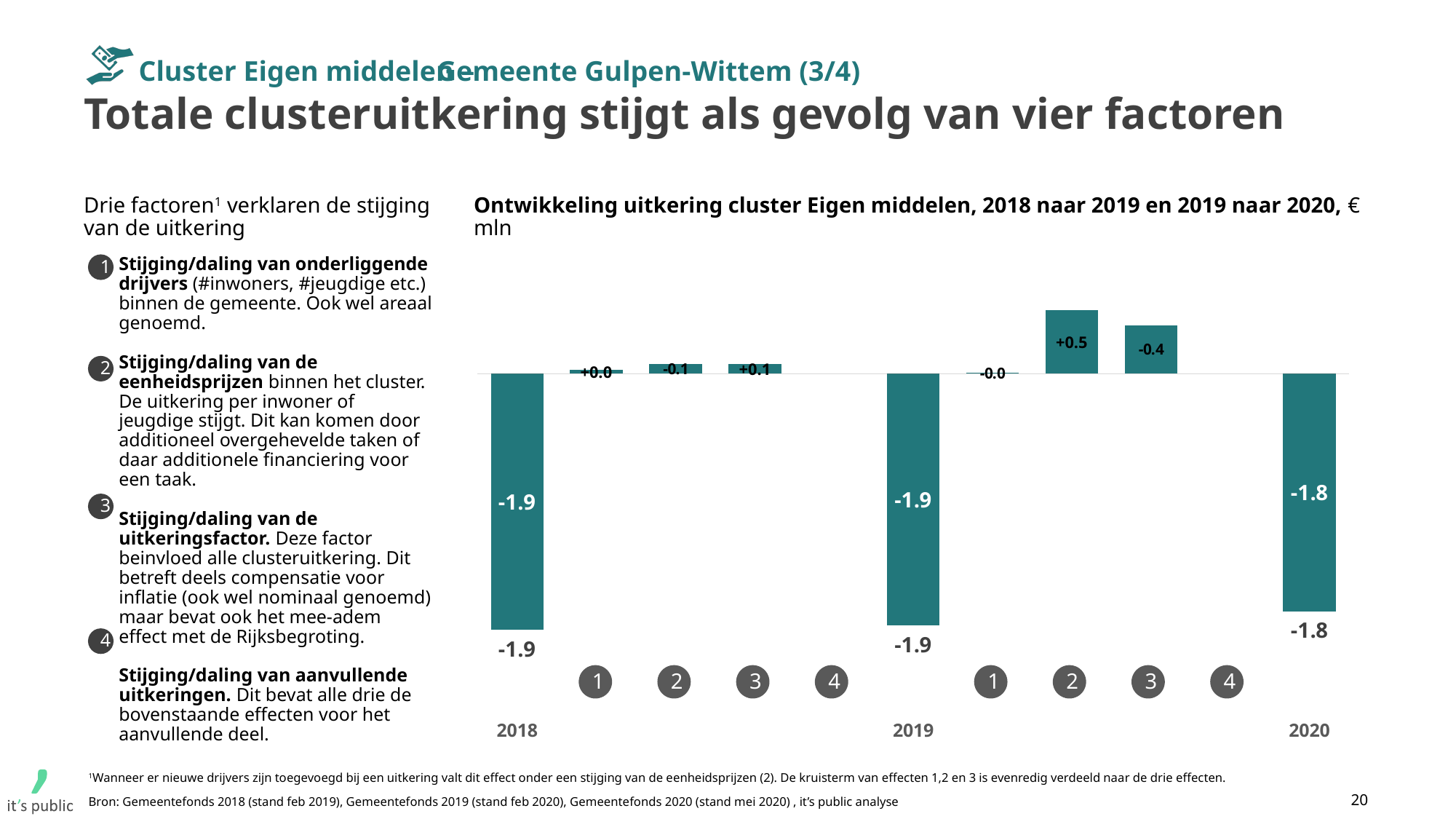
What is the value of factor 3 between 2019 and 2020 in the chart? -0.4 What is the value of factor 2 between 2018 and 2019 in the chart? -0.1 What is the value of the 2020 bar in the chart? -1.8 What is the value of the 2019 bar in the chart? -1.9 What type of chart is shown on the slide? Bar chart (waterfall) What is the difference between the 2020 value and the 2019 value in the chart? 0.1 What unit is stated in the chart title? € mln Which factor between 2019 and 2020 has the largest positive value? Factor 2 What is the value of factor 3 between 2018 and 2019 in the chart? +0.1 What is the value of the 2018 bar in the chart? -1.9 Which is larger, the value of factor 2 between 2019 and 2020 or the value of factor 3 between 2019 and 2020? Factor 2 (+0.5) What is the value of factor 2 between 2019 and 2020 in the chart? +0.5